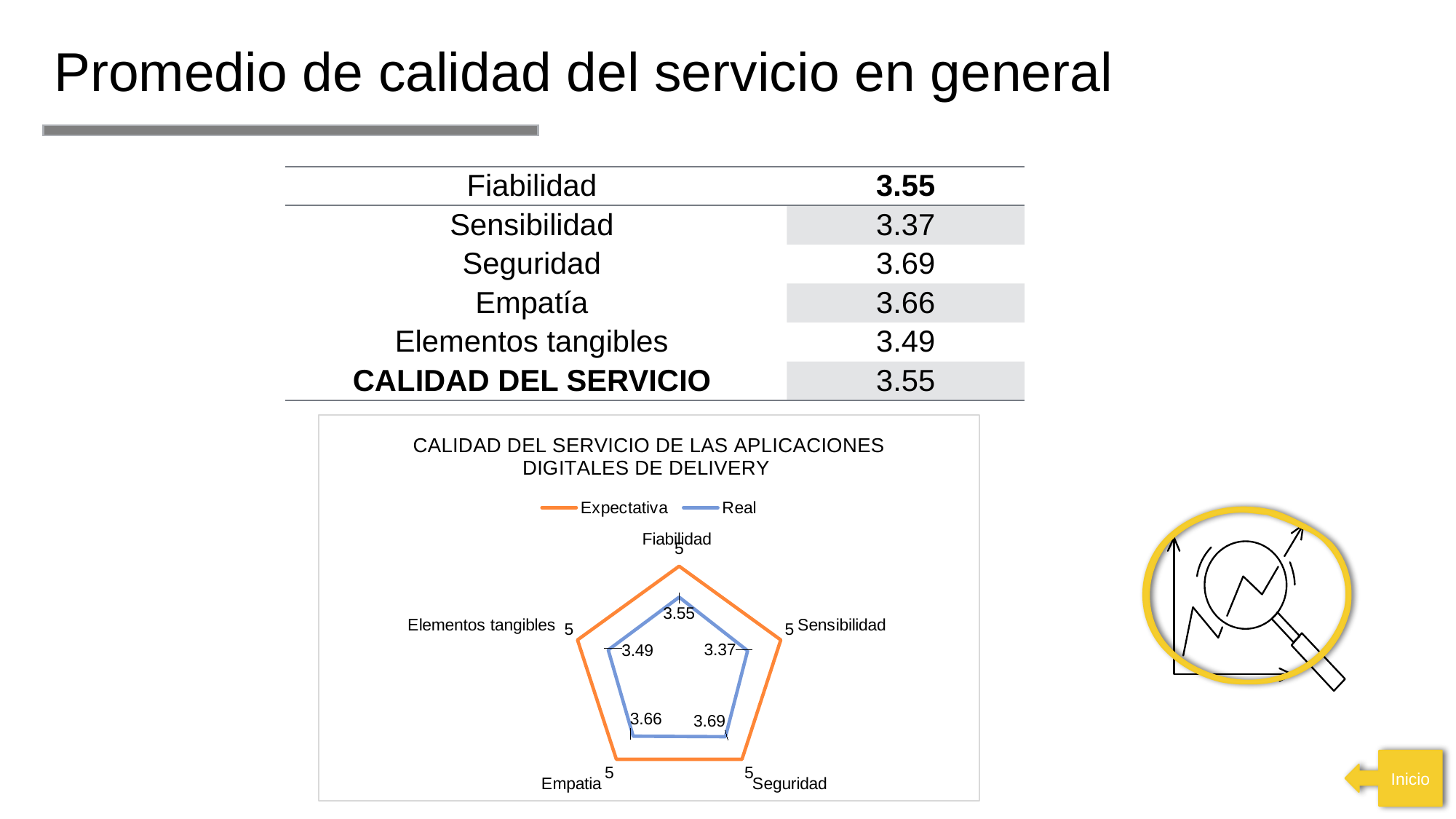
What is the Real value for Fiabilidad? 3.55 What is the title of the chart? CALIDAD DEL SERVICIO DE LAS APLICACIONES DIGITALES DE DELIVERY What type of chart is shown on the slide? Radar chart What is the Real value for Seguridad? 3.69 What is the difference between the Expectativa and Real values for Elementos tangibles? 1.51 Which category has the lowest Real value? Sensibilidad What is the Real value for Sensibilidad? 3.37 What is the Expectativa value for Empatia? 5 How many categories are plotted on the radar chart? 5 Which is larger, the Real value for Empatia or the Real value for Elementos tangibles? Empatia Which category has the highest Real value? Seguridad How many series does the chart legend list? 2